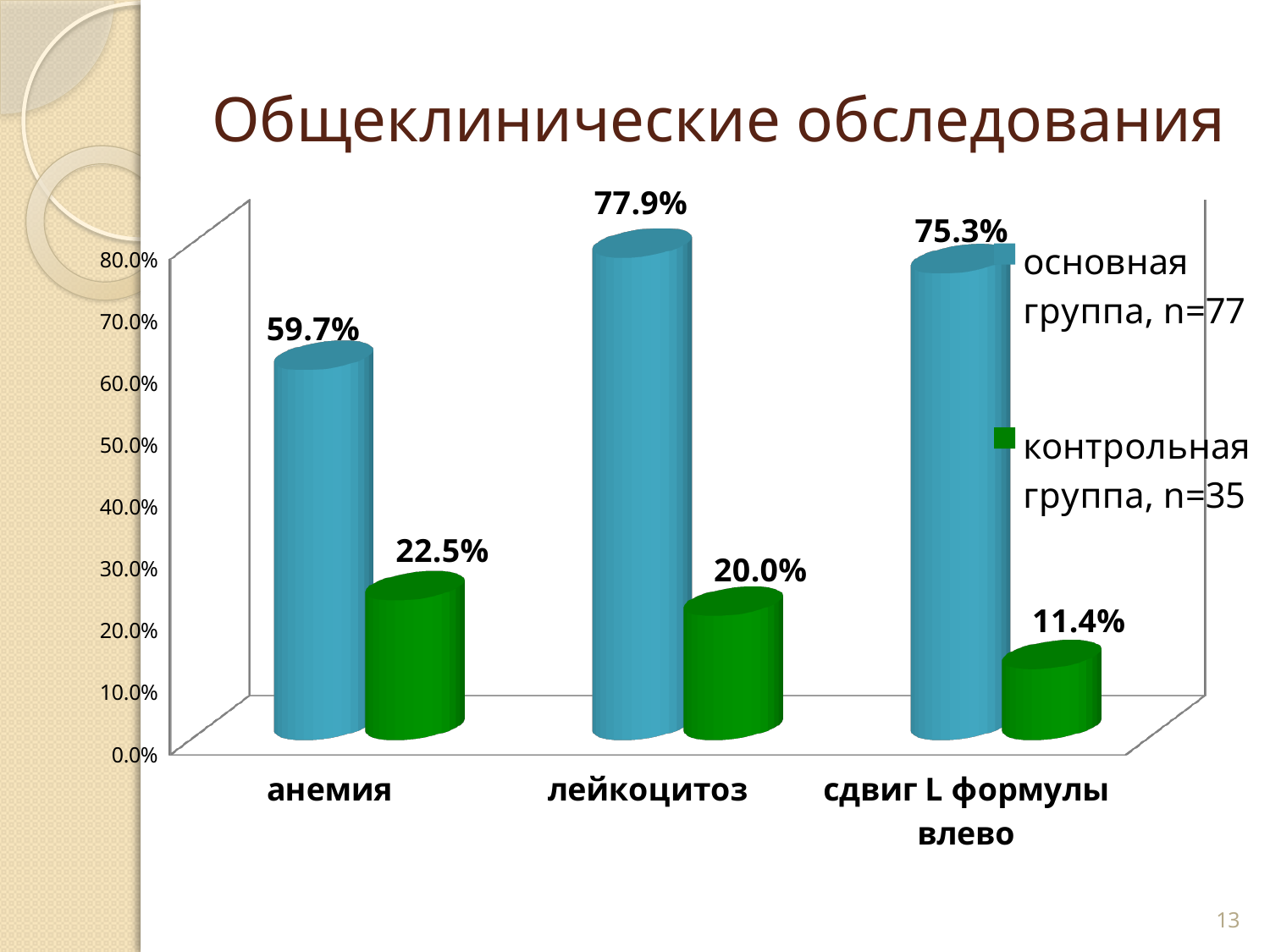
What is the title of the slide? Общеклинические обследования Which category has the lowest value for the контрольная группа, n=35 series? сдвиг L формулы влево What kind of chart is shown on the slide? bar chart What is the difference between the основная группа, n=77 and контрольная группа, n=35 values in the анемия category? 37.2% What colour are the bars for the контрольная группа, n=35 series? green How many categories are shown on the x axis? 3 Which is larger: the контрольная группа, n=35 value for анемия or for лейкоцитоз? анемия What is the value for the основная группа, n=77 series in the анемия category? 59.7% What is the value for the контрольная группа, n=35 series in the лейкоцитоз category? 20.0% How many series does the legend list? 2 Which category has the highest value for the основная группа, n=77 series? лейкоцитоз What is the value for the основная группа, n=77 series in the сдвиг L формулы влево category? 75.3%